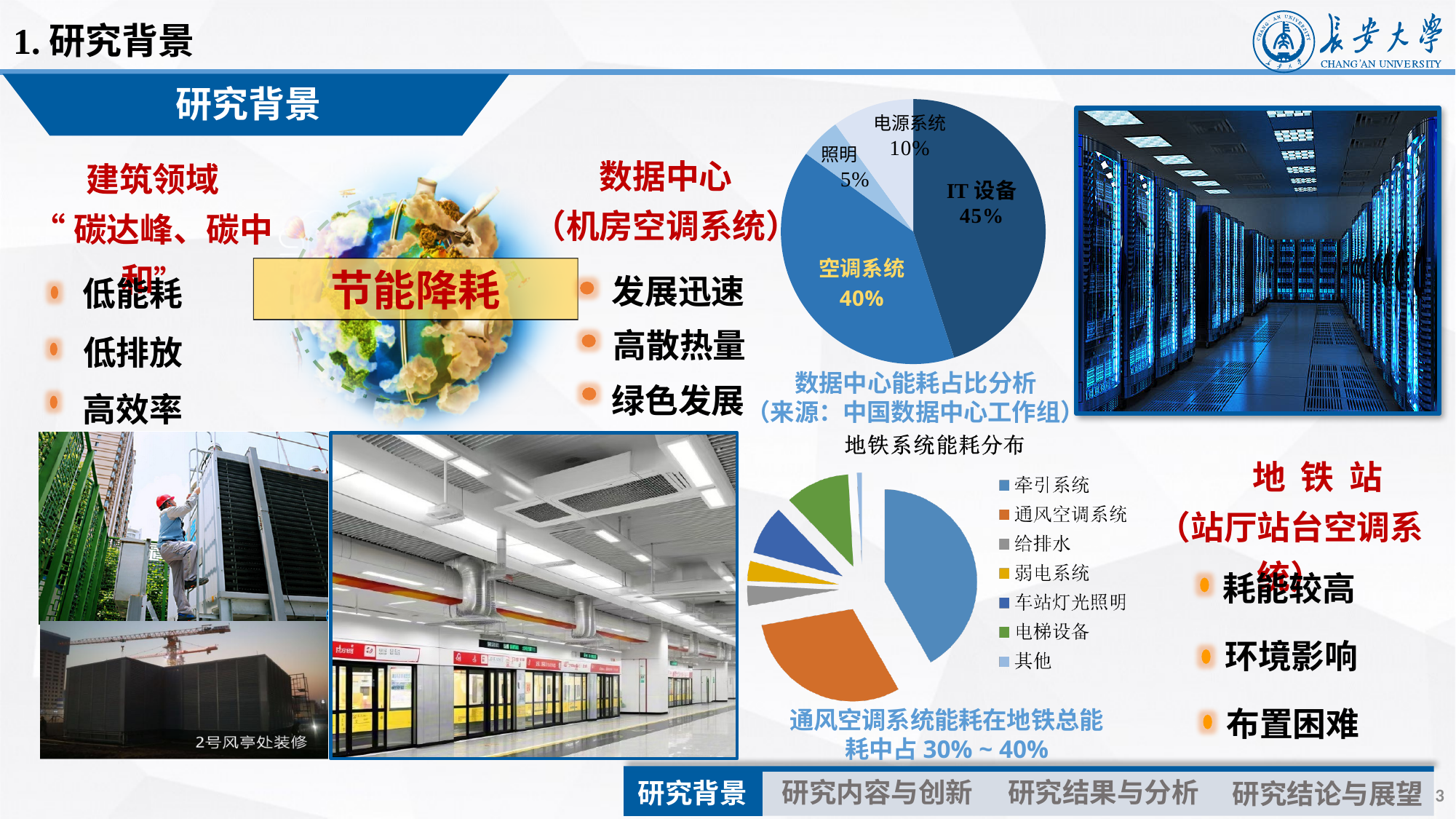
In the 数据中心能耗占比分析 pie chart, what share does 空调系统 account for? 40% In the 数据中心能耗占比分析 pie chart, which category has the smallest share? 照明 In the 地铁系统能耗分布 pie chart, how many categories does the legend list? 7 In the 数据中心能耗占比分析 pie chart, what share does 电源系统 account for? 10% In the 数据中心能耗占比分析 pie chart, what share does 照明 account for? 5% In the 数据中心能耗占比分析 pie chart, what is the difference between the shares of IT 设备 and 空调系统? 5% In the 数据中心能耗占比分析 pie chart, how many categories are shown? 4 In the 数据中心能耗占比分析 pie chart, which category has the largest share? IT 设备 In the 数据中心能耗占比分析 pie chart, what share does IT 设备 account for? 45% In the 地铁系统能耗分布 pie chart, which is larger, the slice for 通风空调系统 or the slice for 给排水? 通风空调系统 In the 地铁系统能耗分布 pie chart, which category has the largest slice? 牵引系统 What kind of chart is the 地铁系统能耗分布 chart? Pie chart